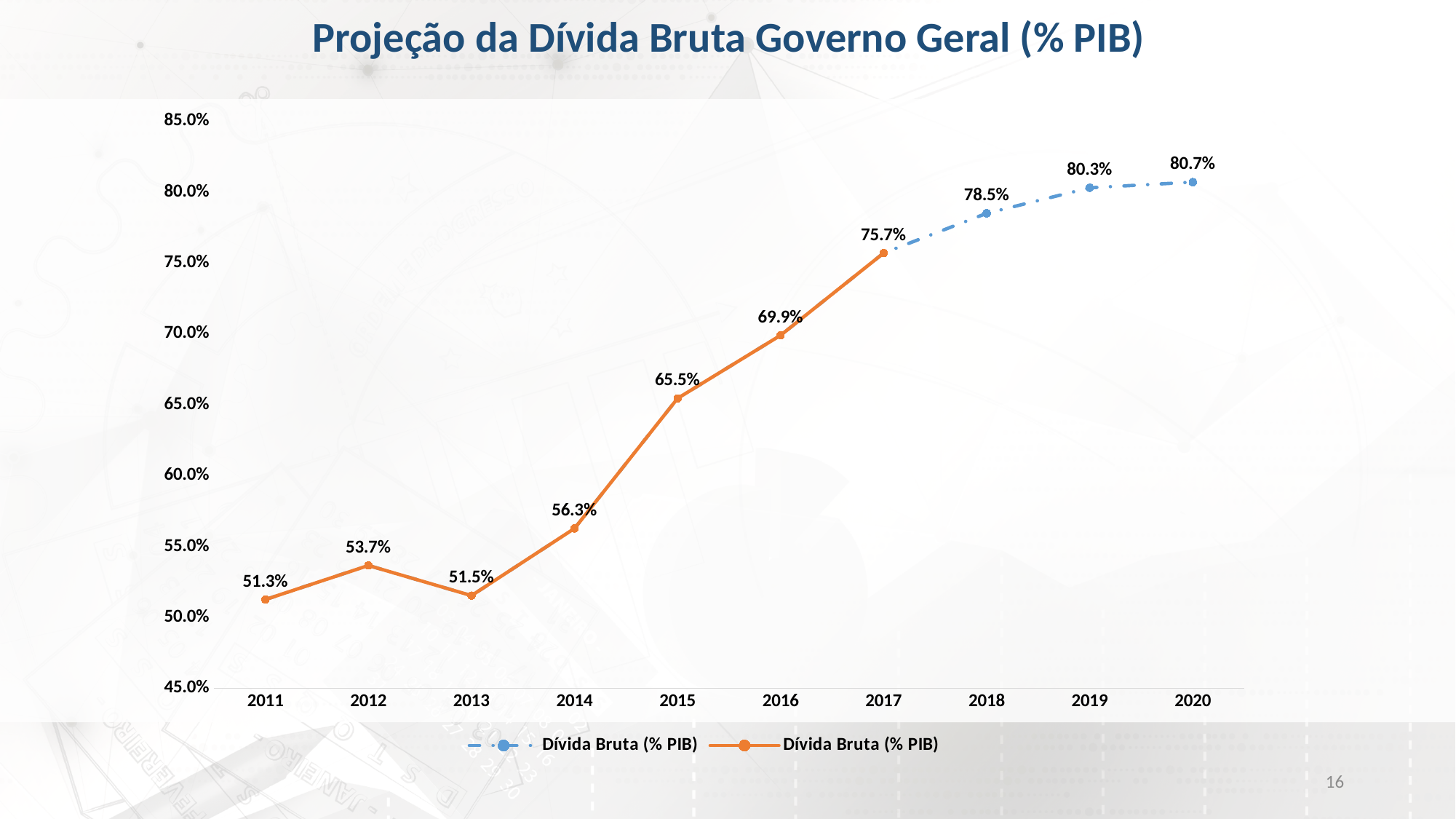
How many series does the legend list? 2 Do the values generally rise or fall from 2013 to 2020? rise What is the difference between the values for 2017 and 2016? 5.8% What kind of chart is shown? line chart Which year has the highest value? 2020 How many years are shown on the x axis? 10 Which is larger, the value for 2012 or the value for 2013? 2012 Which year has the lowest value? 2011 Is the value for 2015 greater or less than 65.0%? greater What is the projected value for 2020? 80.7% What is the value for 2011? 51.3% What is the value for 2016? 69.9%